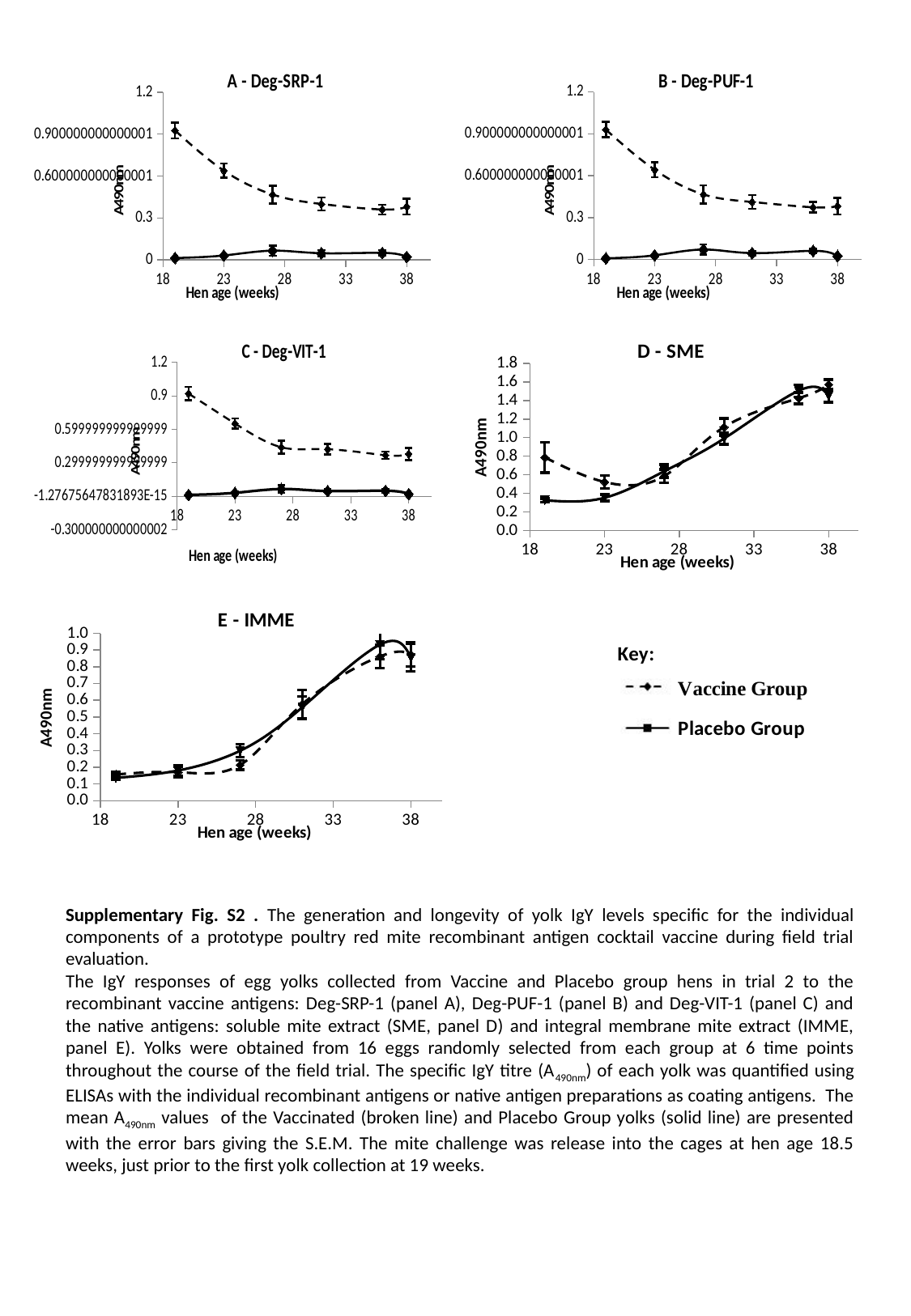
What is the y-axis label on chart D - SME? A490nm In chart D - SME, is the Vaccine Group value at 38 weeks greater or less than 1.2? greater In chart A - Deg-SRP-1, does the Vaccine Group value rise or fall as hen age increases from 19 to 38 weeks? Fall How many series does the key list for the charts? 2 In chart D - SME, does the Placebo Group value rise or fall as hen age increases from 23 to 38 weeks? Rise In chart E - IMME, is the Placebo Group value at 19 weeks greater or less than 0.3? less In chart B - Deg-PUF-1, which group has the larger value at 19 weeks, the Vaccine Group or the Placebo Group? Vaccine Group How many time points are plotted for each group in chart E - IMME? 6 Which line style represents the Vaccine Group in the key? Dashed line In chart D - SME, is the Placebo Group value at 19 weeks greater or less than 0.6? less What kind of chart is panel A - Deg-SRP-1? Line chart